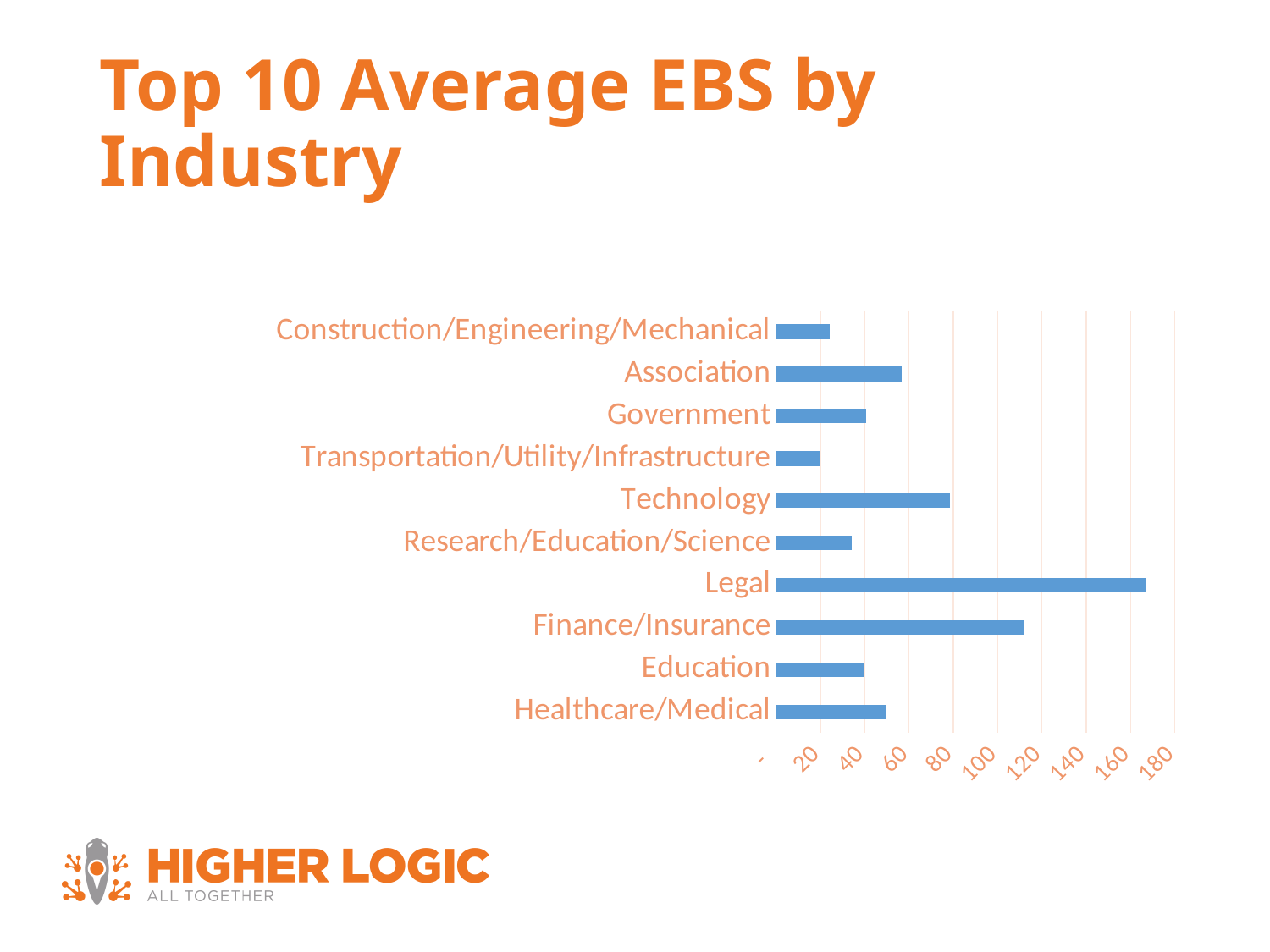
Which has a larger average EBS, Association or Government? Association What kind of chart is shown on the slide? bar chart Which has a larger average EBS, Finance/Insurance or Technology? Finance/Insurance Is the value for Transportation/Utility/Infrastructure greater or less than 40? less Is the value for Construction/Engineering/Mechanical greater or less than 40? less Is the value for Research/Education/Science greater or less than 60? less Which industry has the highest average EBS? Legal How many industries are plotted in the chart? 10 What is the title of the slide containing the chart? Top 10 Average EBS by Industry